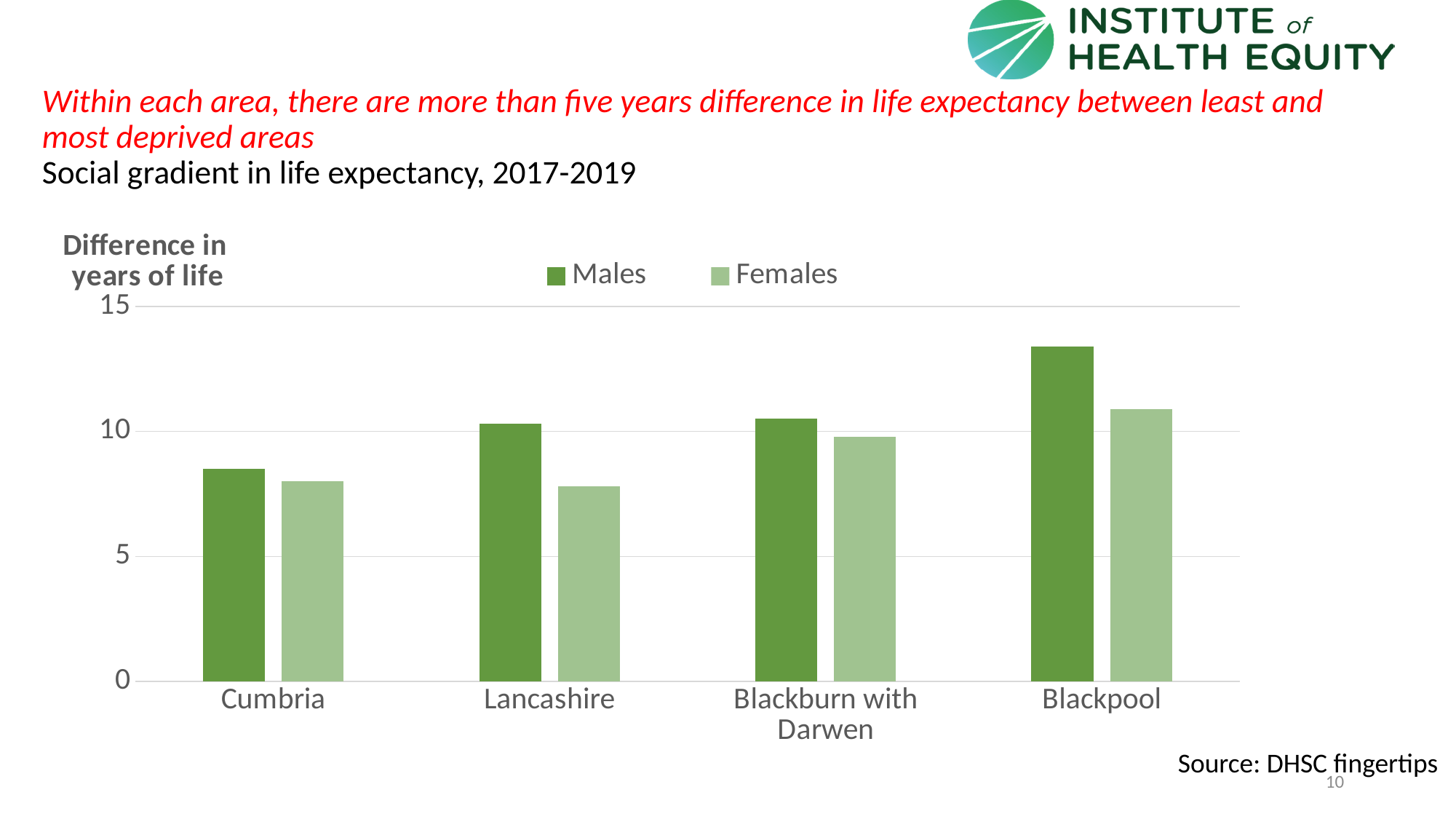
Which area has the highest value for Males? Blackpool What is the label on the vertical axis of the chart? Difference in years of life Is the value for Females in Lancashire greater or less than 10? less How many areas are shown on the x axis? 4 How many series does the legend list? 2 Is the value for Males in Blackpool greater or less than 10? greater Which area has the lowest value for Males? Cumbria Which area has the highest value for Females? Blackpool Do the values for Males rise or fall moving from Cumbria to Blackpool along the x axis? rise What kind of chart is shown on the slide? bar chart Is the value for Males in Cumbria greater or less than 10? less Which is larger in Lancashire, the value for Males or the value for Females? Males